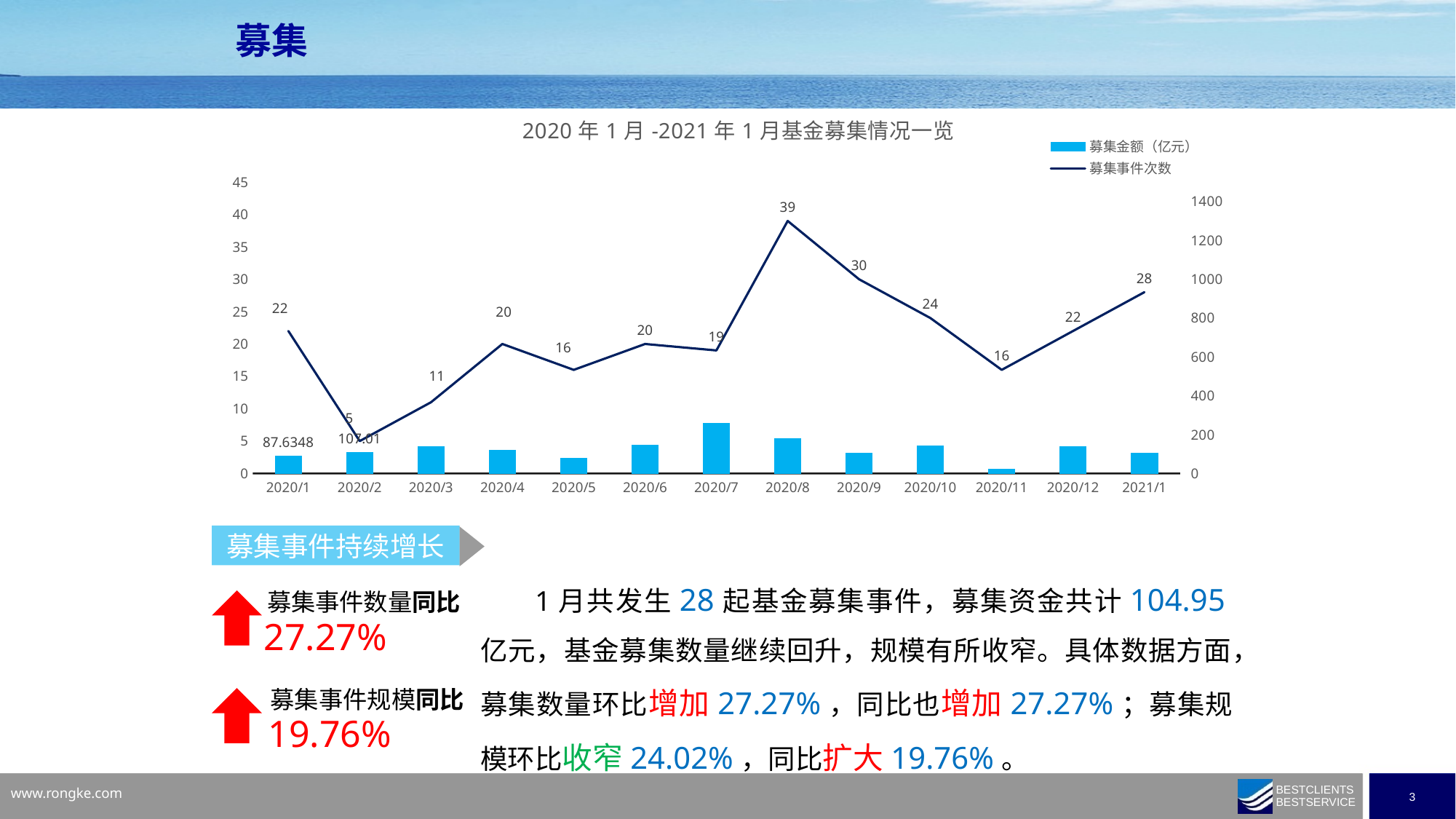
What is the 募集金额（亿元） value for 2020/1? 87.6348 What is the title of the chart? 2020年1月-2021年1月基金募集情况一览 What is the difference in 募集事件次数 between 2020/8 and 2020/9? 9 What is the 募集事件次数 value for 2021/1? 28 What is the 募集事件次数 value for 2020/8? 39 Which month has a higher 募集事件次数, 2020/10 or 2020/12? 2020/10 Which month has the lowest 募集事件次数? 2020/2 How many series does the legend list? 2 What kind of chart is this? Combination bar and line chart Which month has the highest 募集事件次数? 2020/8 Is the 募集金额（亿元） value for 2020/7 greater or less than 200? greater How many months (categories) are shown on the x axis? 13